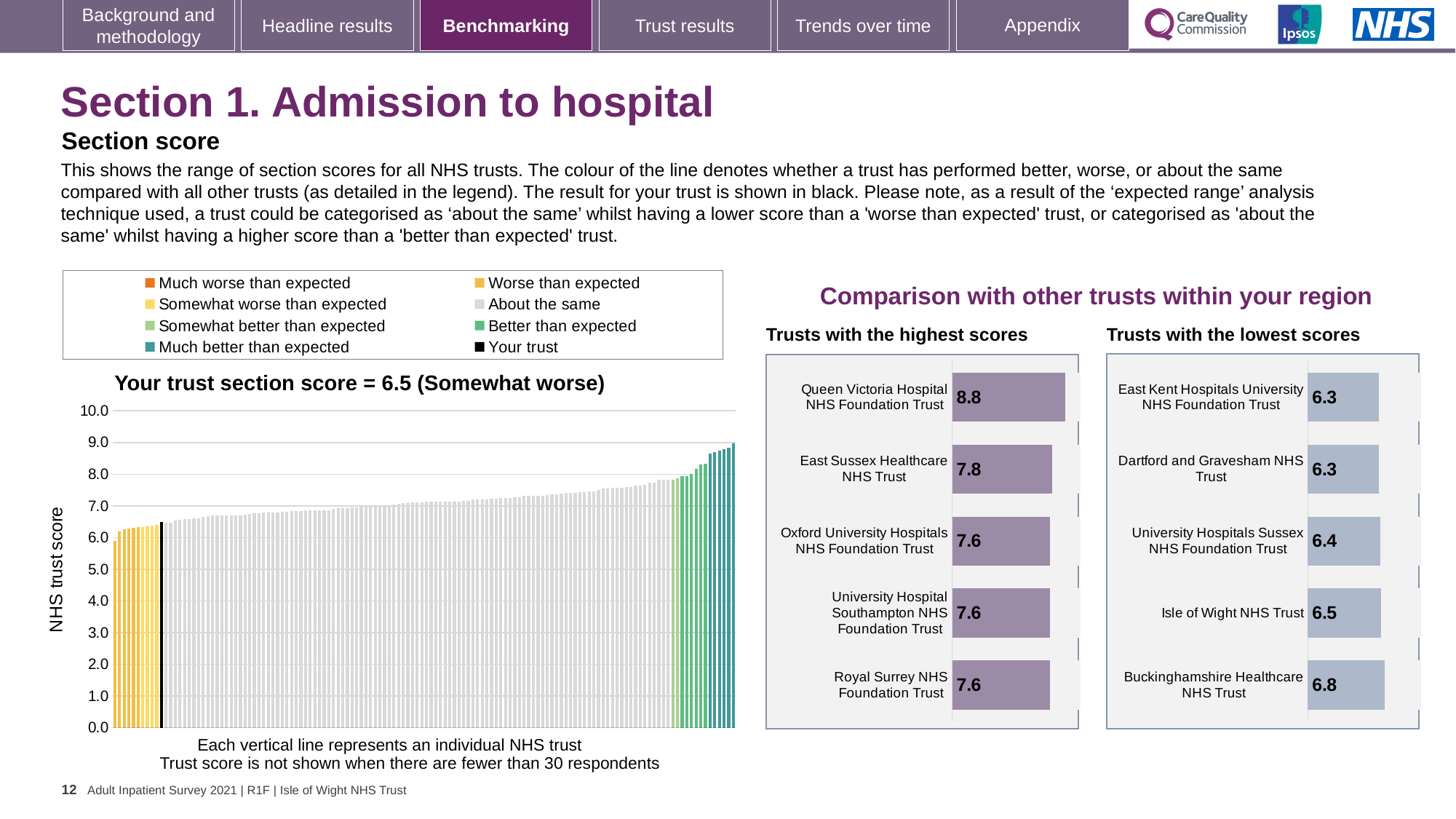
In the 'Your trust section score' chart, do the bars rise or fall from left to right along the x axis? rise In the 'Trusts with the lowest scores' chart, which trust has the highest score? Buckinghamshire Healthcare NHS Trust What kind of chart is the 'Your trust section score' chart? bar chart In the 'Your trust section score' chart, is the value of the tallest bar greater or less than 8.0? greater In the 'Your trust section score' chart, what is the section score for your trust? 6.5 In the 'Trusts with the lowest scores' chart, what is the difference between the scores of Buckinghamshire Healthcare NHS Trust and East Kent Hospitals University NHS Foundation Trust? 0.5 In the 'Trusts with the highest scores' chart, what is the difference between the scores of Queen Victoria Hospital NHS Foundation Trust and East Sussex Healthcare NHS Trust? 1.0 In the 'Trusts with the highest scores' chart, what is the score for Queen Victoria Hospital NHS Foundation Trust? 8.8 In the 'Trusts with the highest scores' chart, how many trusts are shown? 5 How many entries does the legend above the 'Your trust section score' chart list? 8 What is the y-axis label of the 'Your trust section score' chart? NHS trust score In the 'Trusts with the lowest scores' chart, what is the score for Isle of Wight NHS Trust? 6.5